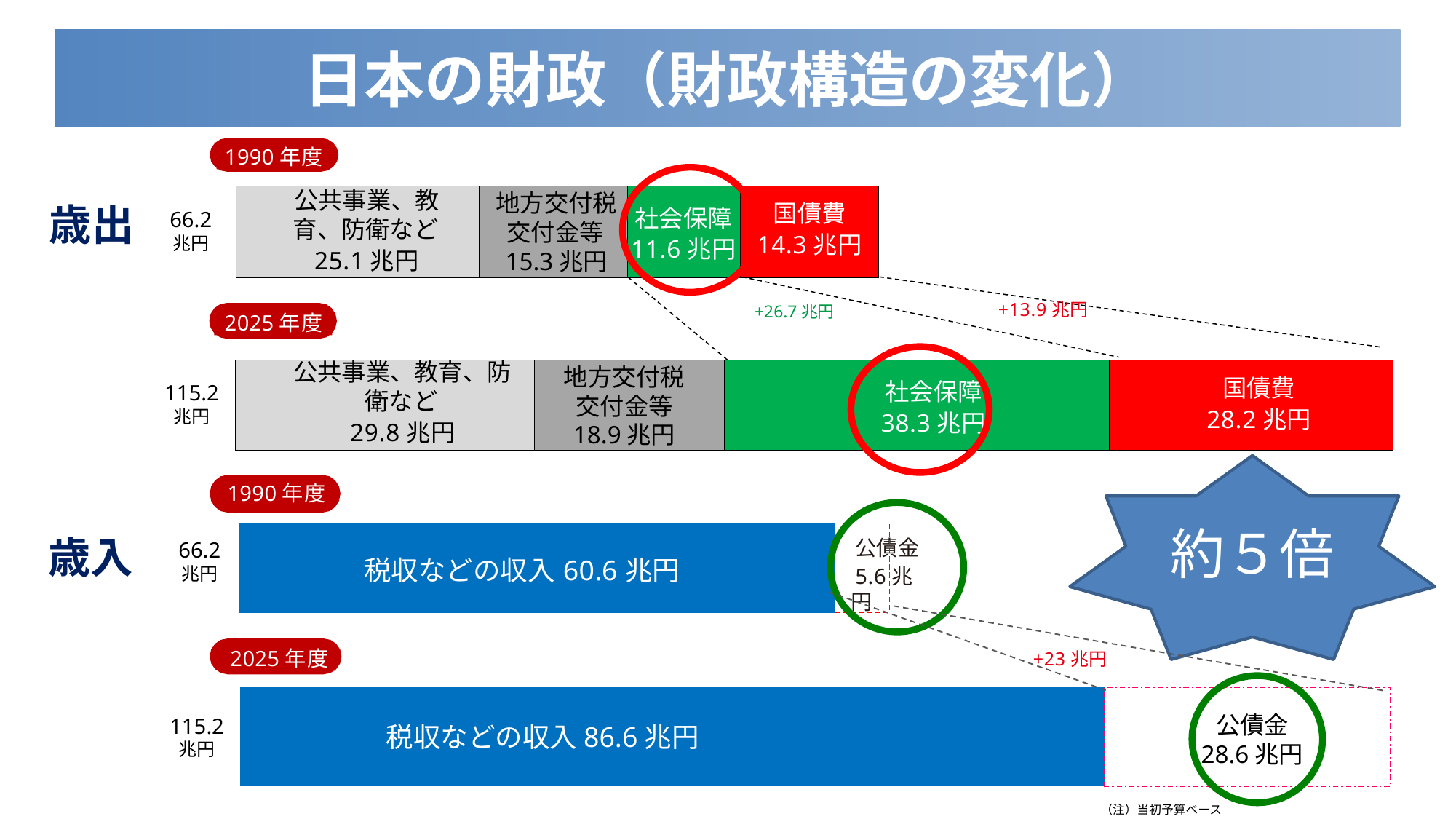
In the 歳出 (expenditure) chart, what is the difference between 社会保障 in 2025年度 and 1990年度? 26.7 兆円 In the 歳出 (expenditure) chart, what is the value of 社会保障 for 1990年度? 11.6 兆円 In the 歳入 (revenue) chart, what is the value of 公債金 for 2025年度? 28.6 兆円 In the 歳出 (expenditure) chart, which segment is the smallest in the 1990年度 bar? 社会保障 In the 歳出 (expenditure) chart, what is the value of 国債費 for 2025年度? 28.2 兆円 What is the total of the 2025年度 歳出 (expenditure) bar? 115.2 兆円 In the 歳入 (revenue) chart, what is the difference between 公債金 in 2025年度 and 1990年度? 23 兆円 In the 歳出 (expenditure) chart, which segment is the largest in the 2025年度 bar? 社会保障 In the 歳出 (expenditure) chart, which is larger in 1990年度: 国債費 or 地方交付税交付金等? 地方交付税交付金等 What kind of chart is used to show 歳出 and 歳入 on this slide? Stacked bar chart How many segments make up each 歳出 (expenditure) bar? 4 In the 歳入 (revenue) chart, what is the value of 税収などの収入 for 1990年度? 60.6 兆円